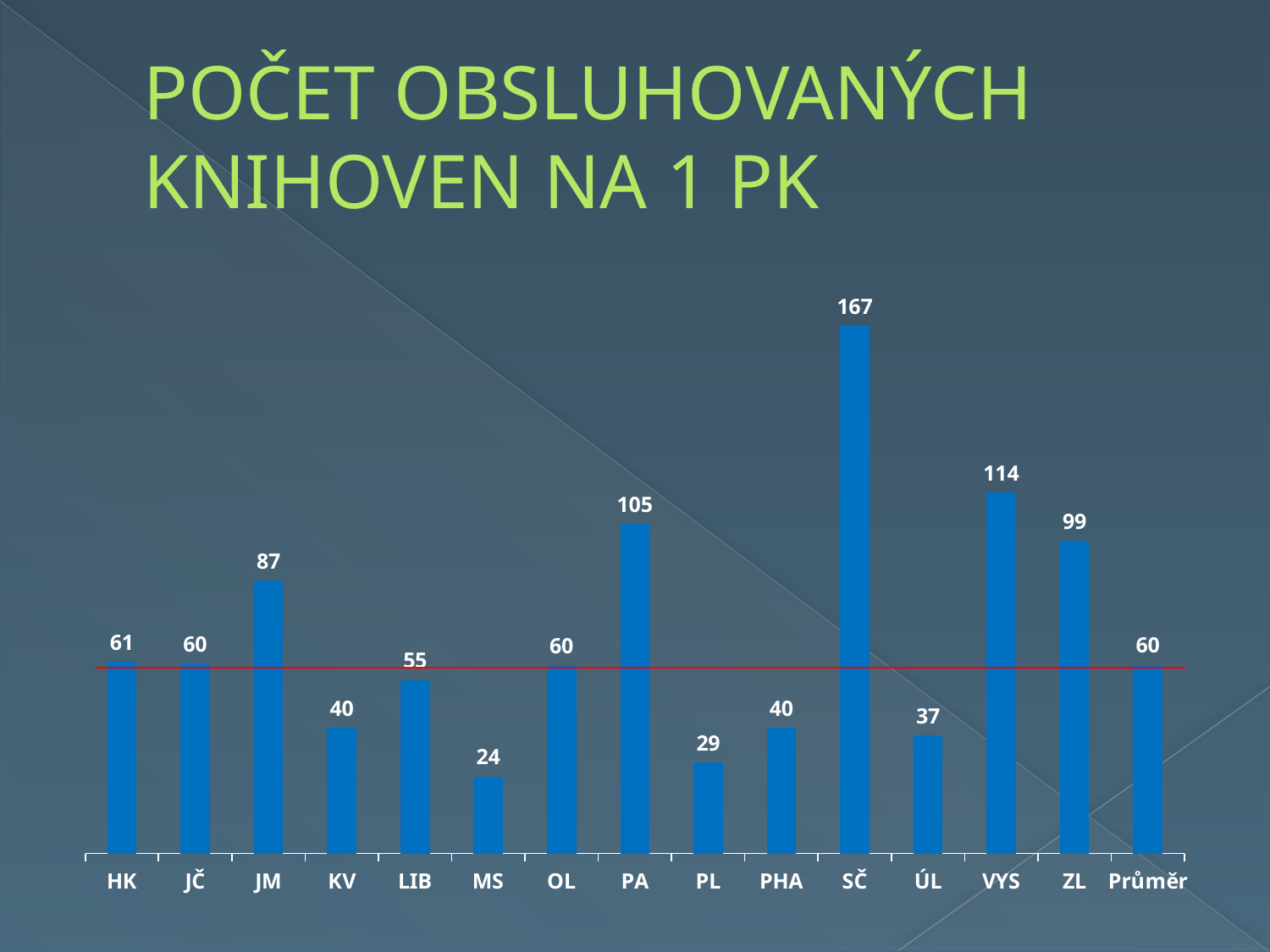
Which category has the lowest value? MS Which category has the highest value? SČ Which is larger, the value for JM or the value for LIB? JM How many categories are shown on the x axis? 15 What is the value for Průměr? 60 What is the value for SČ? 167 Which is larger, the value for PL or the value for ÚL? ÚL What is the value for MS? 24 What is the difference between the values for SČ and VYS? 53 What is the difference between the values for PA and ZL? 6 What kind of chart is shown on the slide? bar chart What is the title of the chart? POČET OBSLUHOVANÝCH KNIHOVEN NA 1 PK